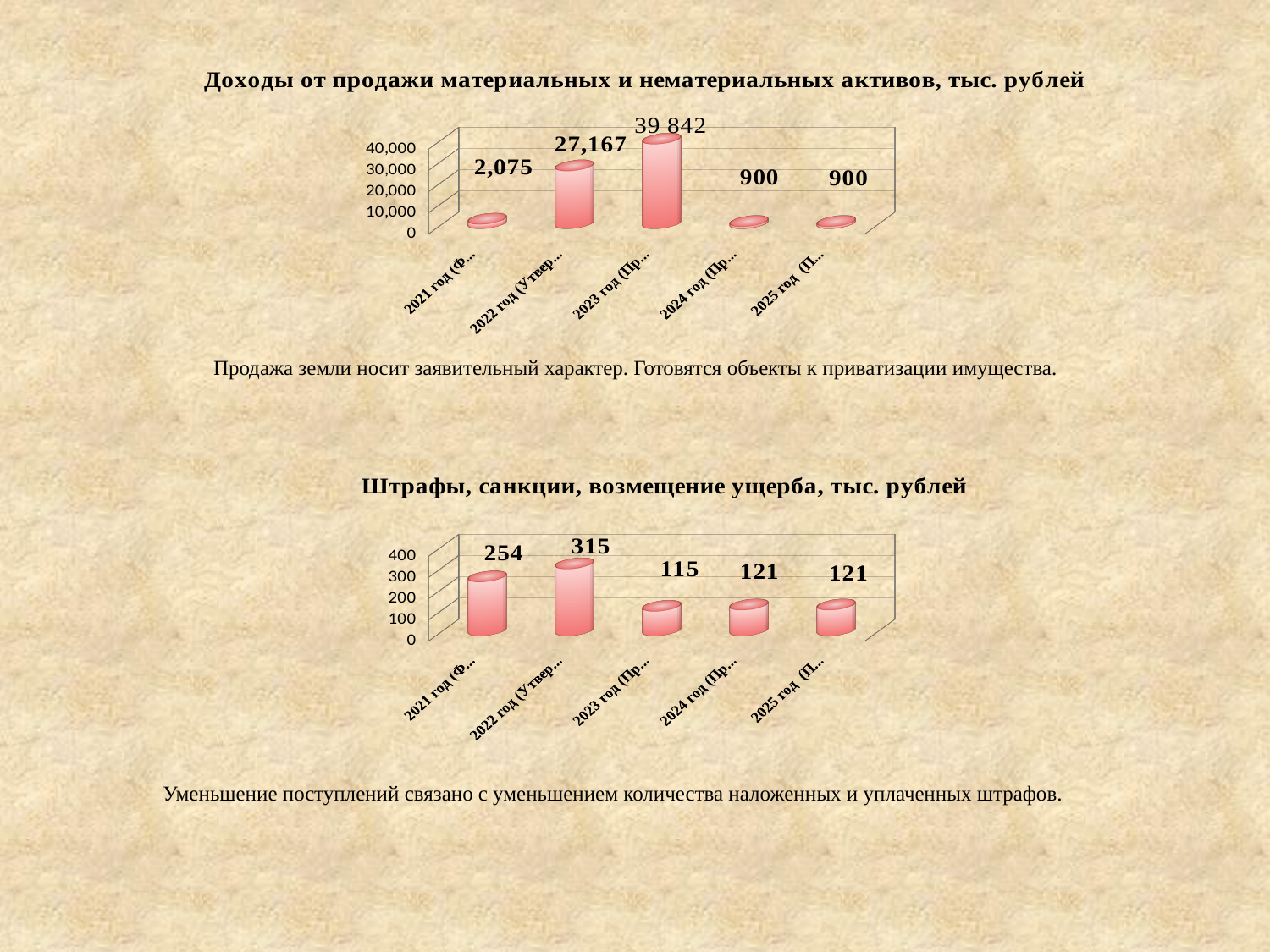
In the chart titled "Доходы от продажи материальных и нематериальных активов, тыс. рублей", what is the value for 2023? 39 842 In the chart titled "Доходы от продажи материальных и нематериальных активов, тыс. рублей", how many years are shown on the x axis? 5 In the chart titled "Штрафы, санкции, возмещение ущерба, тыс. рублей", what is the difference between the values for 2022 and 2023? 200 In the chart titled "Доходы от продажи материальных и нематериальных активов, тыс. рублей", what is the value for 2022? 27,167 In the chart titled "Доходы от продажи материальных и нематериальных активов, тыс. рублей", which year has the highest value? 2023 In the chart titled "Штрафы, санкции, возмещение ущерба, тыс. рублей", which is larger, the value for 2021 or the value for 2022? 2022 In the chart titled "Штрафы, санкции, возмещение ущерба, тыс. рублей", which year has the lowest value? 2023 In the chart titled "Штрафы, санкции, возмещение ущерба, тыс. рублей", is the value for 2021 greater or less than 200? greater What kind of chart is the one titled "Штрафы, санкции, возмещение ущерба, тыс. рублей"? bar chart In the chart titled "Доходы от продажи материальных и нематериальных активов, тыс. рублей", is the value for 2022 greater or less than 20,000? greater In the chart titled "Штрафы, санкции, возмещение ущерба, тыс. рублей", what is the value for 2022? 315 In the chart titled "Доходы от продажи материальных и нематериальных активов, тыс. рублей", what is the difference between the values for 2022 and 2021? 25,092